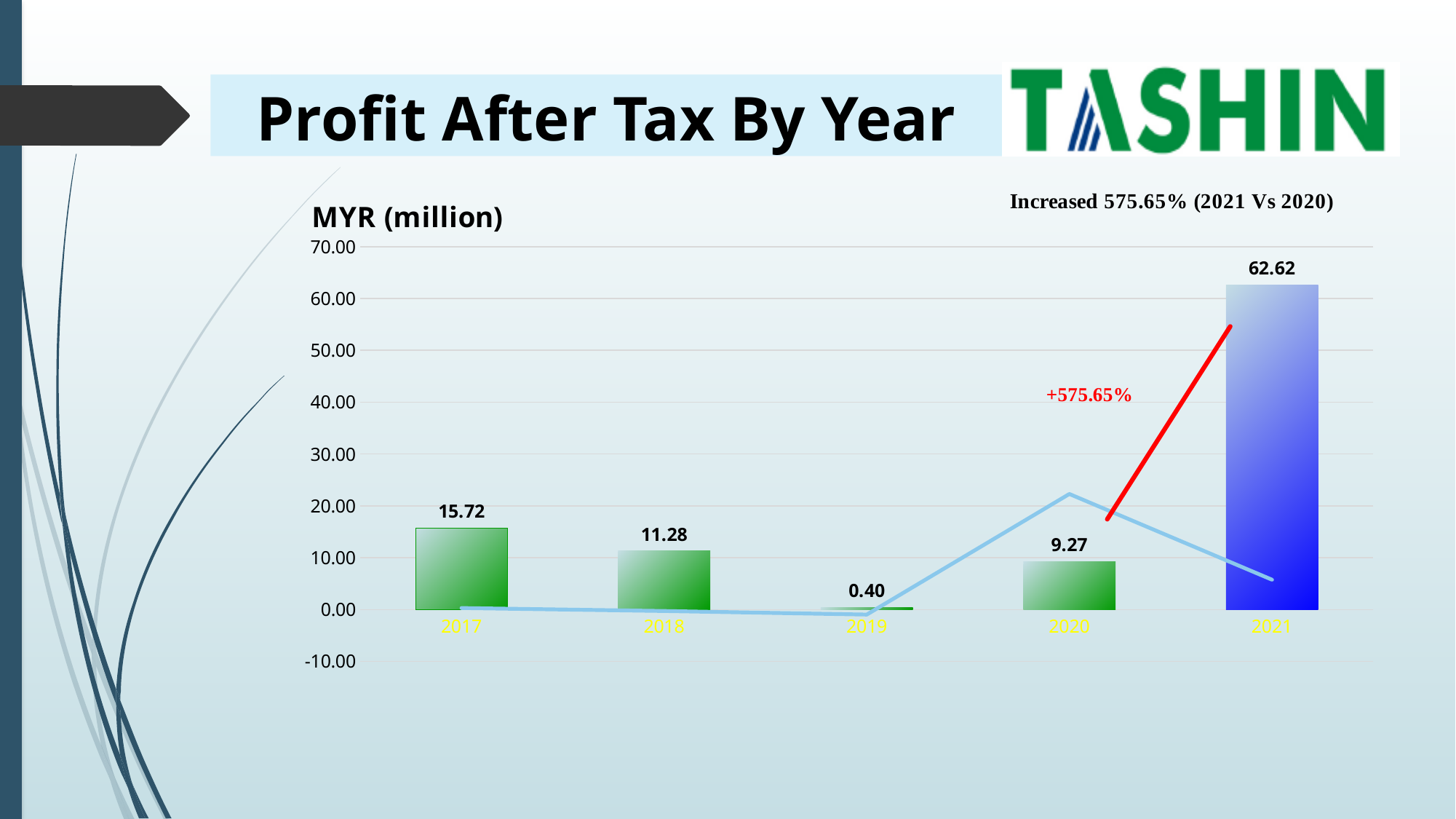
Which year has the lowest profit after tax? 2019 What unit is shown on the vertical axis label? MYR (million) What kind of chart is used to show profit after tax by year? bar chart Which year has the highest profit after tax? 2021 What is the difference in profit after tax between 2021 and 2020? 53.35 What is the profit after tax for 2017? 15.72 Which year has a larger profit after tax, 2017 or 2018? 2017 What is the profit after tax for 2020? 9.27 What is the profit after tax for 2021? 62.62 How many years are shown on the x axis? 5 What is the profit after tax for 2019? 0.40 Is the value for 2021 greater or less than 60.00? greater